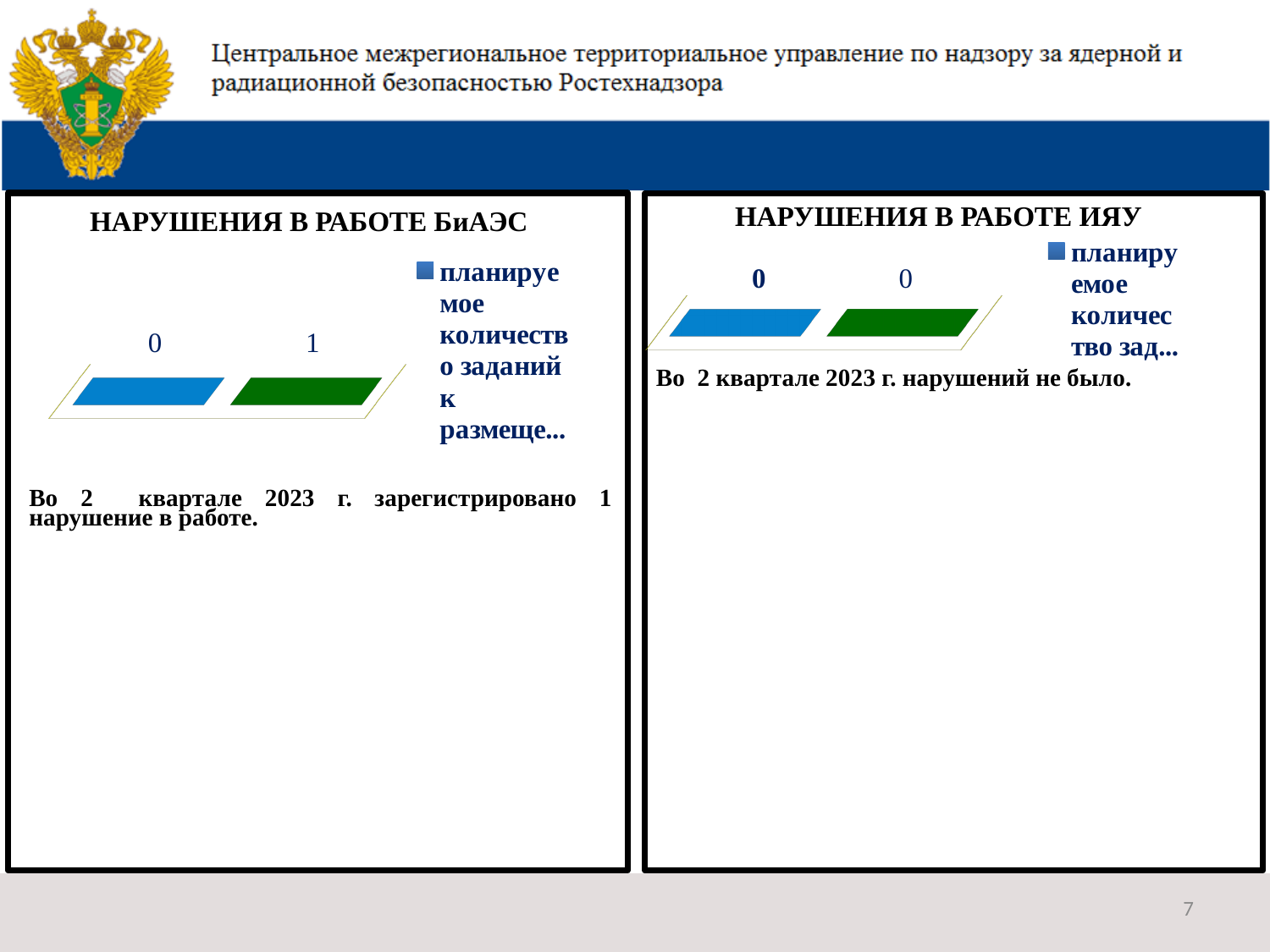
In the chart titled "НАРУШЕНИЯ В РАБОТЕ ИЯУ", how many entries does the legend list? 1 What kind of chart is shown under the title "НАРУШЕНИЯ В РАБОТЕ БиАЭС"? bar chart In the chart titled "НАРУШЕНИЯ В РАБОТЕ БиАЭС", how many bars are plotted? 2 In the chart titled "НАРУШЕНИЯ В РАБОТЕ БиАЭС", what is the sum of the two bar values? 1 In the chart titled "НАРУШЕНИЯ В РАБОТЕ ИЯУ", what value is shown on the blue bar? 0 In the chart titled "НАРУШЕНИЯ В РАБОТЕ БиАЭС", which bar has the higher value, the blue one or the green one? the green bar What is the title of the chart on the left side of the slide? НАРУШЕНИЯ В РАБОТЕ БиАЭС In the chart titled "НАРУШЕНИЯ В РАБОТЕ БиАЭС", what value is shown on the blue bar? 0 In the chart titled "НАРУШЕНИЯ В РАБОТЕ БиАЭС", what value is shown on the green bar? 1 In the chart titled "НАРУШЕНИЯ В РАБОТЕ БиАЭС", what is the difference between the green bar's value and the blue bar's value? 1 In the chart titled "НАРУШЕНИЯ В РАБОТЕ ИЯУ", how many bars are plotted? 2 In the chart titled "НАРУШЕНИЯ В РАБОТЕ ИЯУ", what value is shown on the green bar? 0